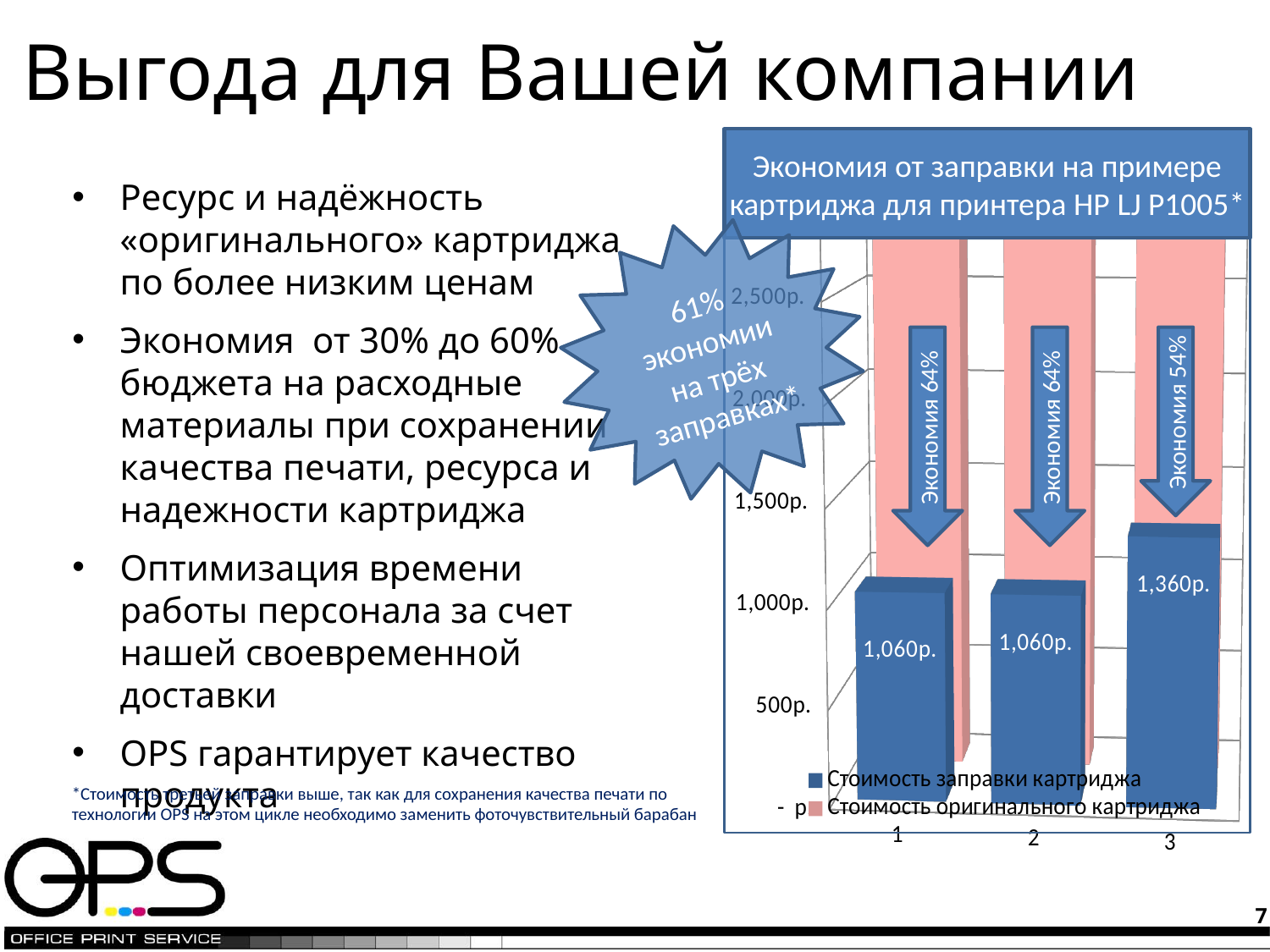
What kind of chart is shown on the slide? bar chart Is the value of 'Стоимость оригинального картриджа' for category 1 greater or less than 2,000р.? greater What savings percentage is written on the arrow above category 3? Экономия 54% How many series does the chart legend list? 2 How many categories are shown on the x axis of the chart? 3 Which is larger: 'Стоимость заправки картриджа' for category 2 or for category 3? 3 Is the value of 'Стоимость заправки картриджа' for category 2 greater or less than 1,500р.? less What is the value of 'Стоимость заправки картриджа' for category 3? 1,360р. What is the difference between 'Стоимость заправки картриджа' for category 3 and category 1? 300р. Which category has the highest 'Стоимость заправки картриджа'? 3 What is the value of 'Стоимость заправки картриджа' for category 1? 1,060р. Does 'Стоимость заправки картриджа' rise or fall from category 1 to category 3? rise